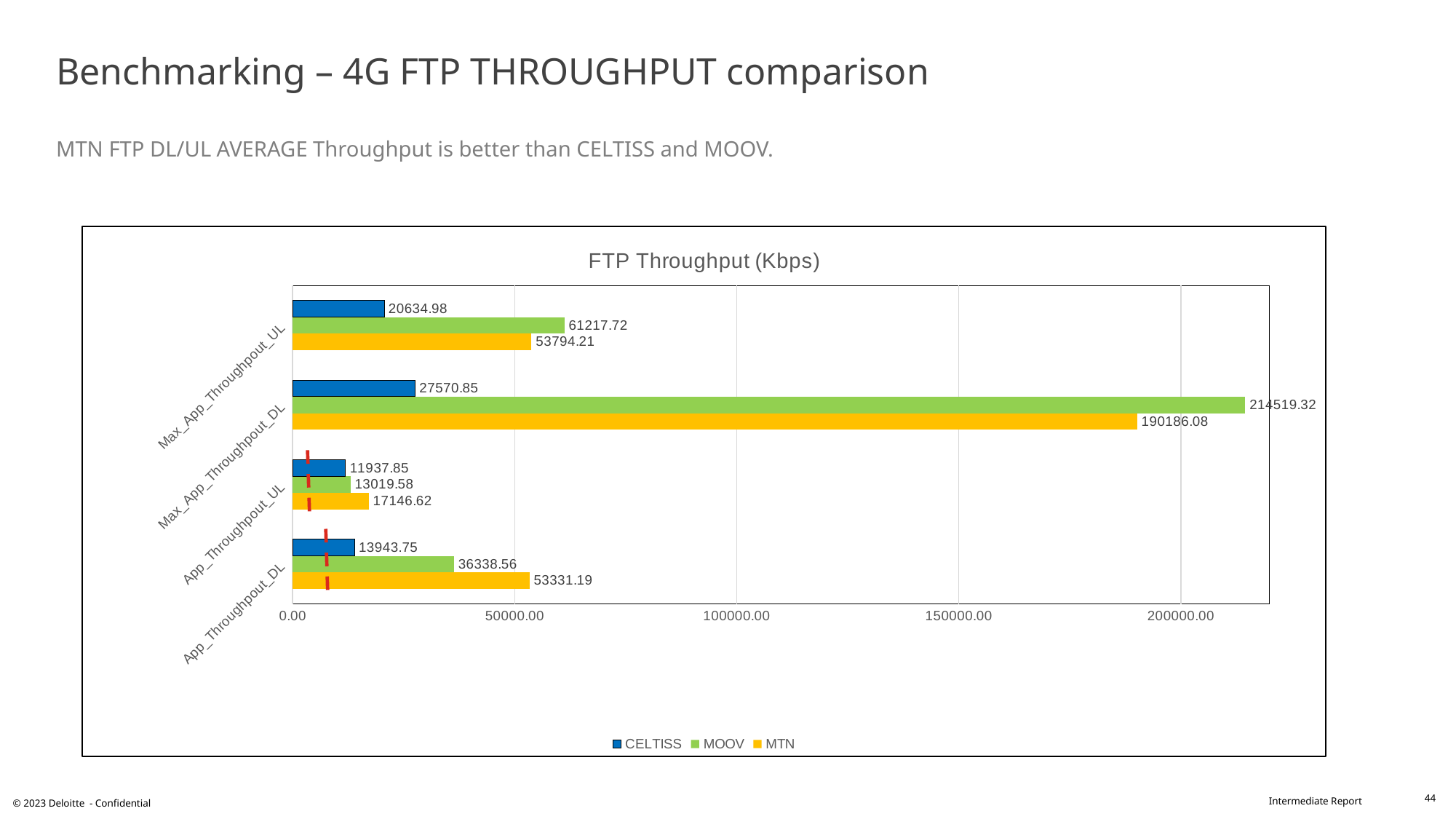
Is the MTN value for Max_App_Throughpout_DL greater or less than 150000.00? greater What is the CELTISS value for App_Throughpout_UL? 11937.85 How many series does the legend list? 3 For Max_App_Throughpout_UL, which is larger: the MOOV value or the MTN value? MOOV What is the MOOV value for Max_App_Throughpout_DL? 214519.32 What is the MTN value for Max_App_Throughpout_UL? 53794.21 What type of chart is shown? Bar chart Which series has the highest value for Max_App_Throughpout_DL? MOOV What is the difference between the MOOV and MTN values for Max_App_Throughpout_DL? 24333.24 What is the difference between the MTN and MOOV values for App_Throughpout_DL? 16992.63 Which series has the lowest value for App_Throughpout_DL? CELTISS What is the MTN value for App_Throughpout_DL? 53331.19